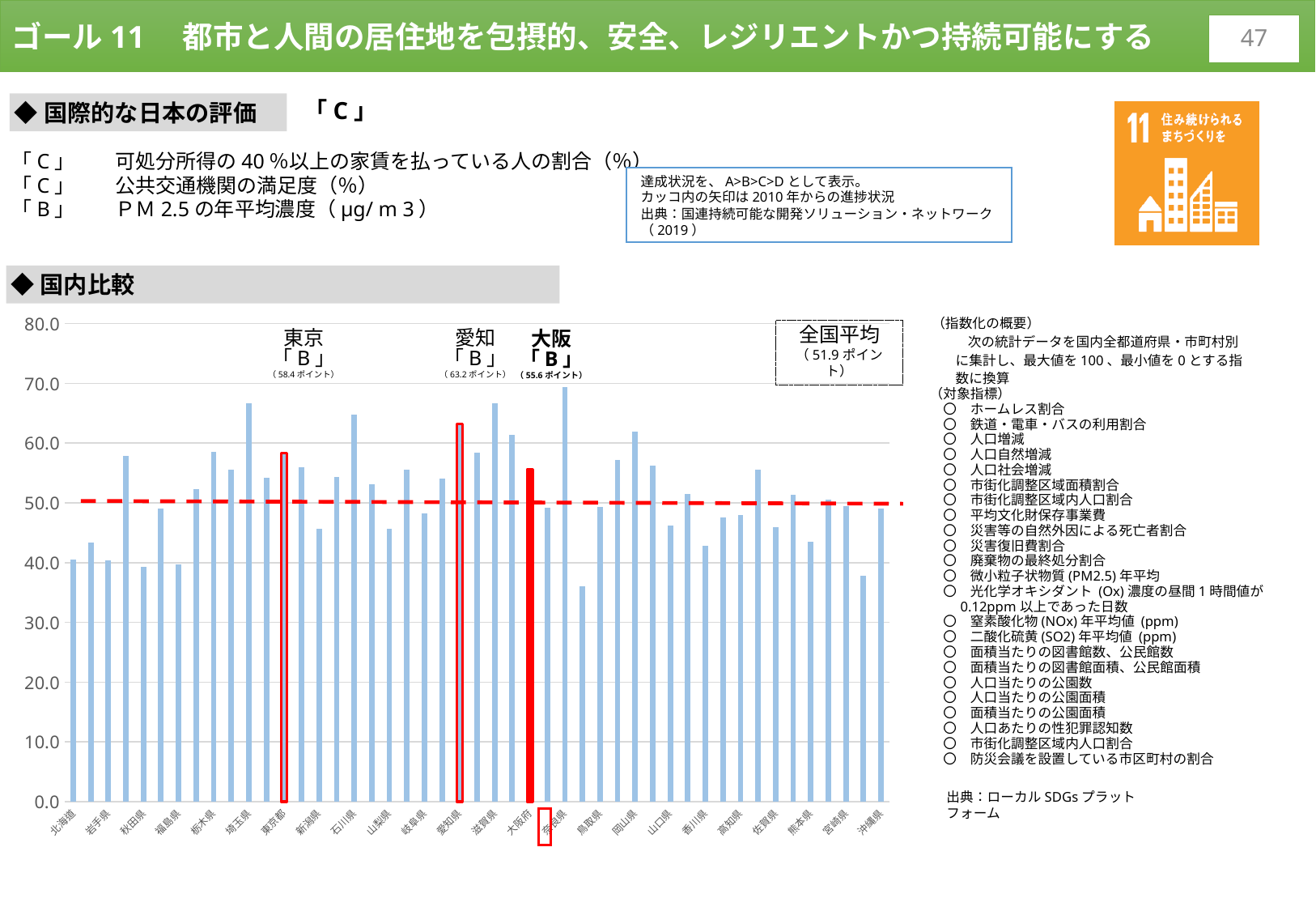
In the 国内比較 bar chart, what is the difference between the values for 愛知 and 東京? 4.8 ポイント In the 国内比較 bar chart, what value is shown for 東京? 58.4 ポイント In the 国内比較 bar chart, what does the red dashed horizontal line represent? 全国平均 In the 国内比較 bar chart, what is the 全国平均 value? 51.9 ポイント In the 国内比較 bar chart, which has the larger value, 愛知 or 大阪? 愛知 In the 国内比較 bar chart, is the value for 北海道 greater or less than 50.0? less In the 国内比較 bar chart, what value is shown for 大阪? 55.6 ポイント In the 国内比較 bar chart, what is the difference between the values for 東京 and 大阪? 2.8 ポイント In the 国内比較 bar chart, what value is shown for 愛知? 63.2 ポイント In the 国内比較 bar chart, is the value for 埼玉県 greater or less than 60.0? greater In the 国内比較 bar chart, is the value for 鳥取県 greater or less than 40.0? greater What kind of chart is used in the 国内比較 section? bar chart